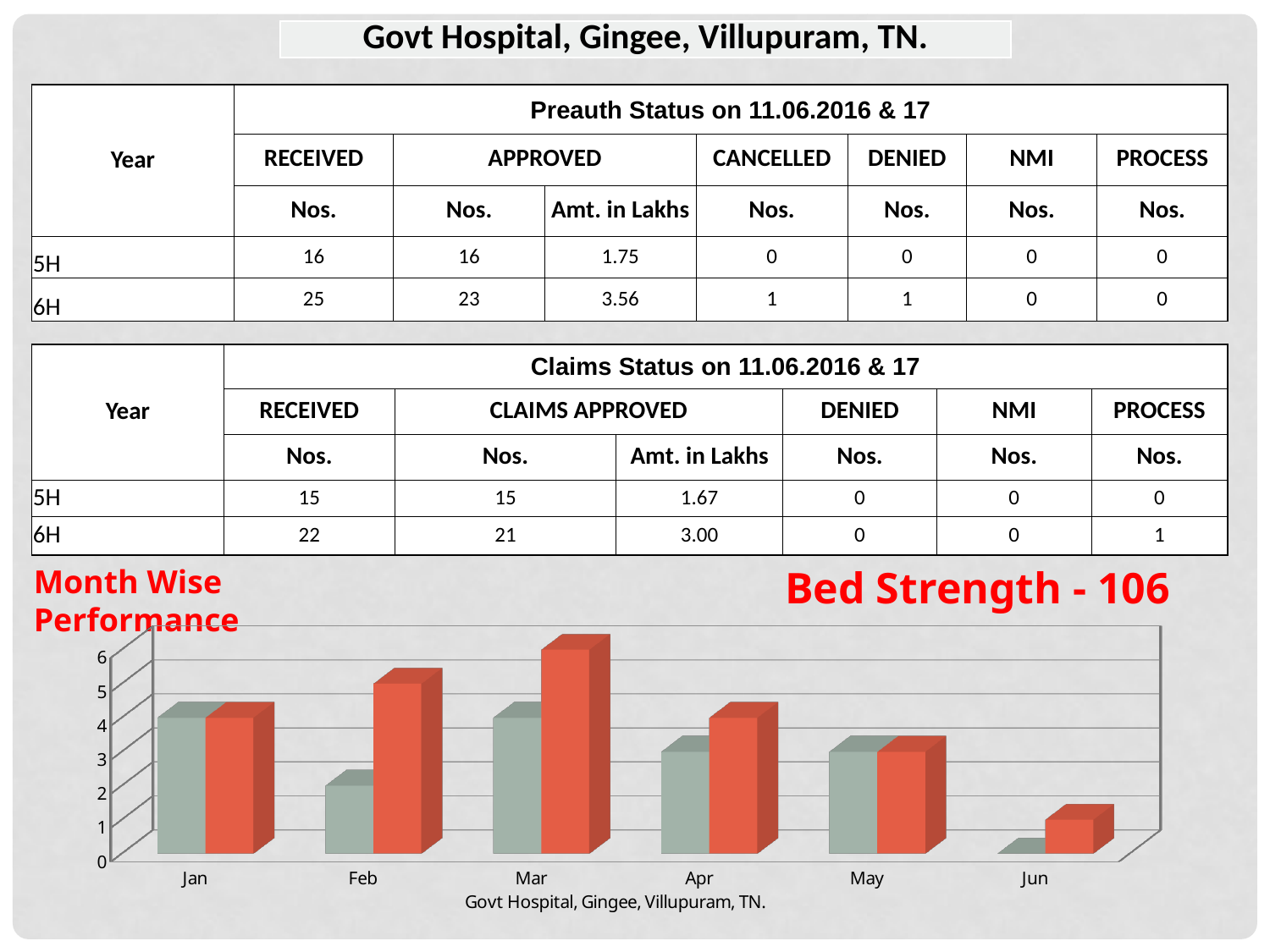
What kind of chart is shown at the bottom of the slide? Bar chart In the Month Wise Performance chart, which is larger, the red bar for Mar or the red bar for Apr? Mar In the Month Wise Performance chart, which month has the highest red bar? Mar In the Month Wise Performance chart, do the red bars rise or fall from Apr to Jun? Fall In the Month Wise Performance chart, is the red bar for Mar greater or less than 5? greater How many months are shown on the x axis of the Month Wise Performance chart? 6 In the Month Wise Performance chart, which month has the lowest grey bar? Jun In the Month Wise Performance chart, is the grey bar for Feb greater or less than 3? less In the Month Wise Performance chart, is the red bar for Jun greater or less than 2? less In the Month Wise Performance chart, which month has the lowest red bar? Jun In the Month Wise Performance chart, which is larger for Feb, the grey bar or the red bar? The red bar What text appears below the x axis of the Month Wise Performance chart? Govt Hospital, Gingee, Villupuram, TN.